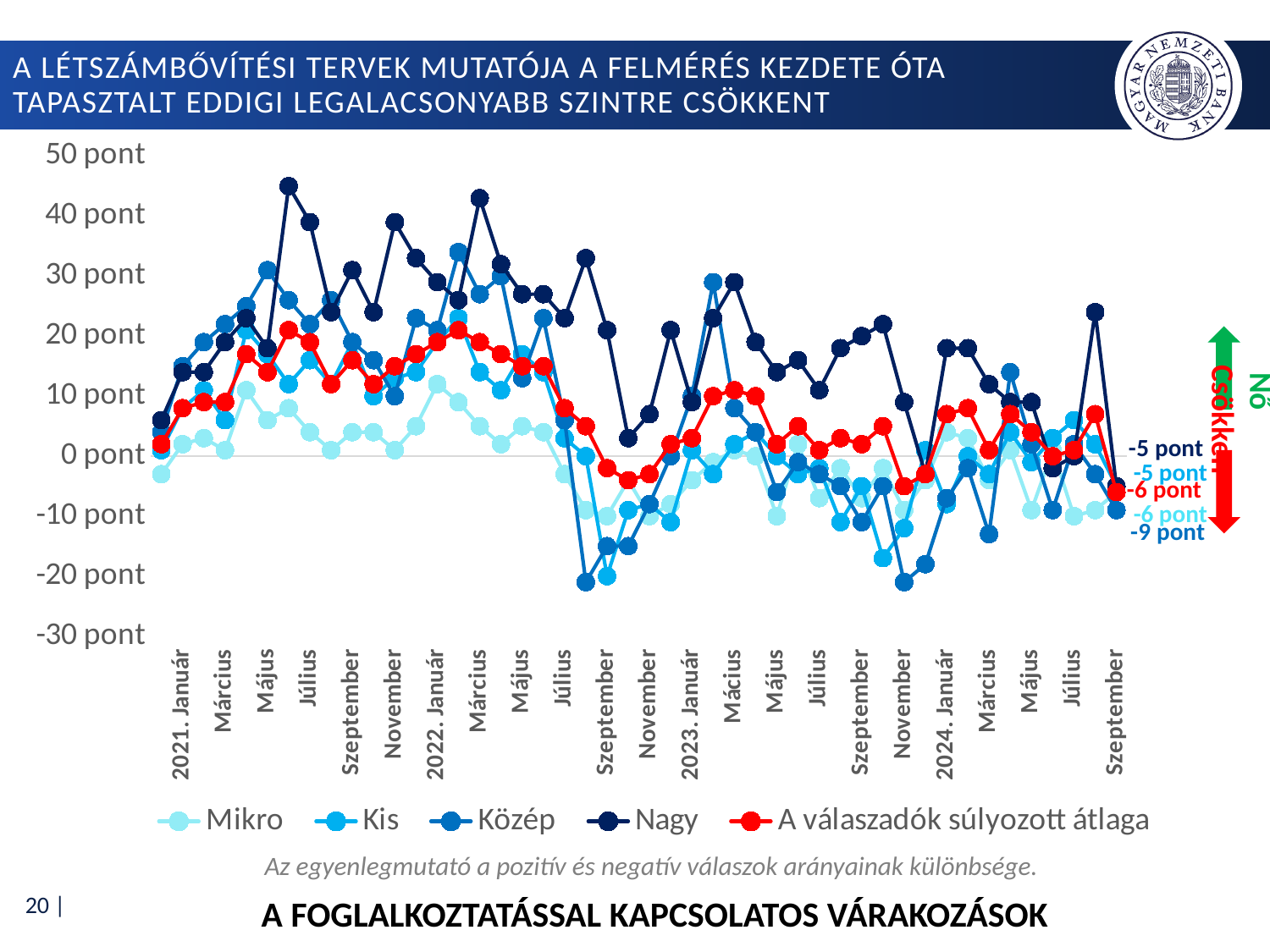
What is the final value of the Közép series? -9 pont What kind of chart is shown on the slide? line chart Is the highest value reached by the Mikro series greater or less than 20 pont? less Which series has the lowest value at the end of the chart? Közép Which legend entry is drawn in red? A válaszadók súlyozott átlaga How many series does the legend list? 5 Is the highest value reached by the Nagy series greater or less than 40 pont? greater What is the difference between the final Nagy value (-5 pont) and the final Közép value (-9 pont)? 4 pont At the end of the chart, which is larger: the Nagy value or the Közép value? Nagy What is the value of 'A válaszadók súlyozott átlaga' at the end of the series (Szeptember 2024)? -6 pont What is the final value of the Nagy series? -5 pont Overall, does 'A válaszadók súlyozott átlaga' rise or fall from 2021 to Szeptember 2024? fall